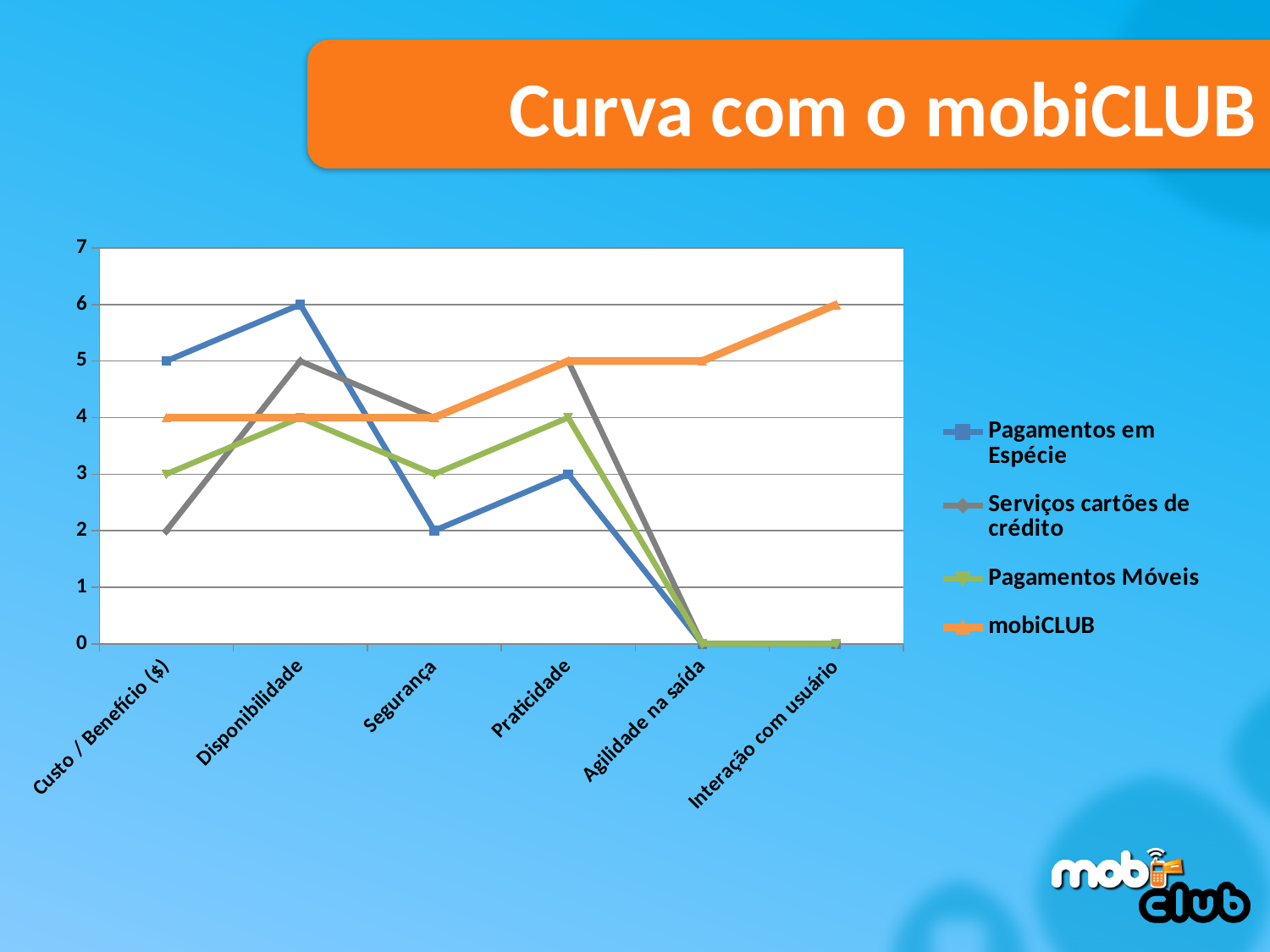
What is the value for Pagamentos Móveis at Segurança? 3 Does the mobiCLUB series rise or fall from Agilidade na saída to Interação com usuário? rise Which series has the lowest value at Custo / Benefício ($)? Serviços cartões de crédito What is the difference between Pagamentos em Espécie and mobiCLUB at Disponibilidade? 2 What is the value for mobiCLUB at Interação com usuário? 6 What is the value for Serviços cartões de crédito at Custo / Benefício ($)? 2 Which series has the highest value at Agilidade na saída? mobiCLUB At Segurança, which is larger: Serviços cartões de crédito or Pagamentos em Espécie? Serviços cartões de crédito What is the value for Pagamentos em Espécie at Disponibilidade? 6 How many categories are shown on the x axis? 6 How many series does the legend list? 4 What kind of chart is shown on the slide? line chart